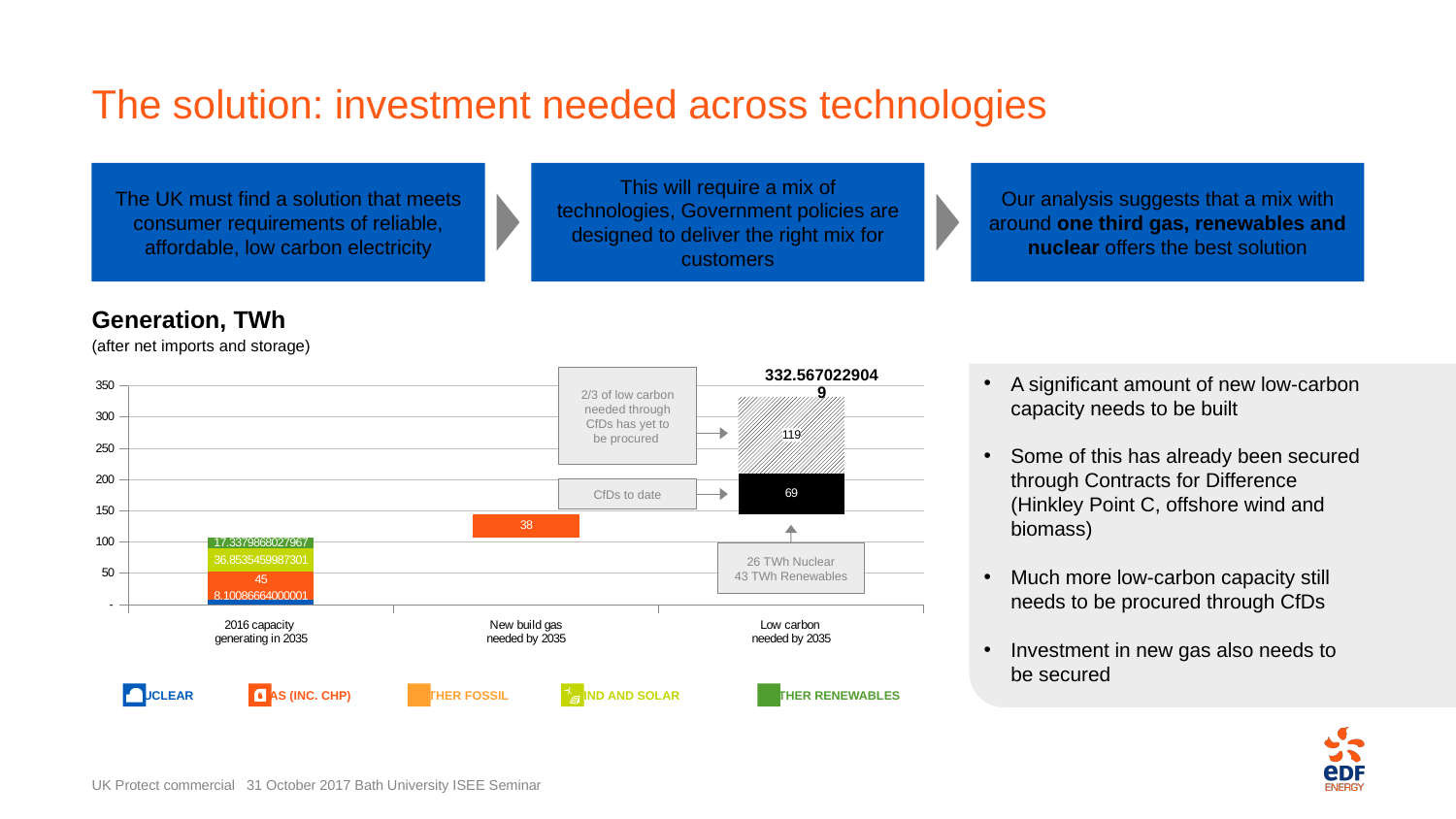
How many series does the chart legend list? 5 What is the value of the hatched segment representing low carbon yet to be procured through CfDs? 119 Is the total of the '2016 capacity generating in 2035' bar greater or less than 150? less What is the value of the 'CfDs to date' segment in the 'Low carbon needed by 2035' bar? 69 What is the difference between the low carbon yet to be procured (119) and the CfDs to date (69)? 50 Which category has the tallest bar? Low carbon needed by 2035 What is the value of the bar for 'New build gas needed by 2035'? 38 What is the value of the gas (inc. CHP) segment in the '2016 capacity generating in 2035' bar? 45 How many categories are shown on the x axis of the chart? 3 Which category has the shortest bar? New build gas needed by 2035 What kind of chart is shown on the slide? Stacked bar chart